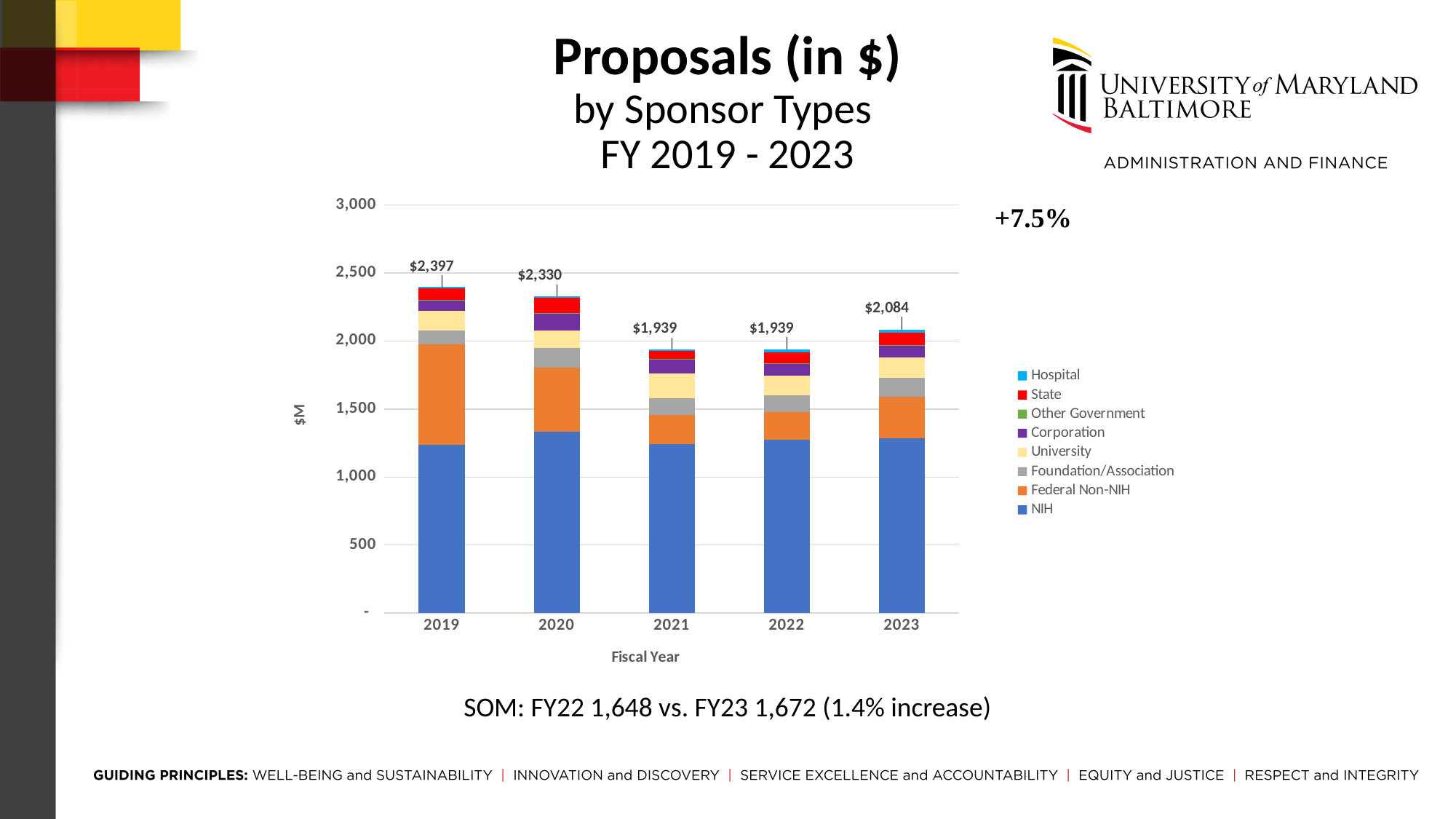
What is the difference between the total for 2023 and the total for 2022? $145 What kind of chart is shown on the slide? stacked bar chart What is the total proposal value labeled for fiscal year 2023? $2,084 What is the total proposal value labeled for fiscal year 2019? $2,397 What is the difference between the total for 2019 and the total for 2020? $67 What is the title of the x axis? Fiscal Year Is the NIH value for 2019 greater or less than 1,000? greater How many sponsor types does the legend list? 8 Which fiscal year has the highest total proposal value? 2019 Which has a larger total, 2020 or 2023? 2020 Do the total proposal values rise or fall from 2019 to 2021? fall How many fiscal years are shown on the x axis? 5